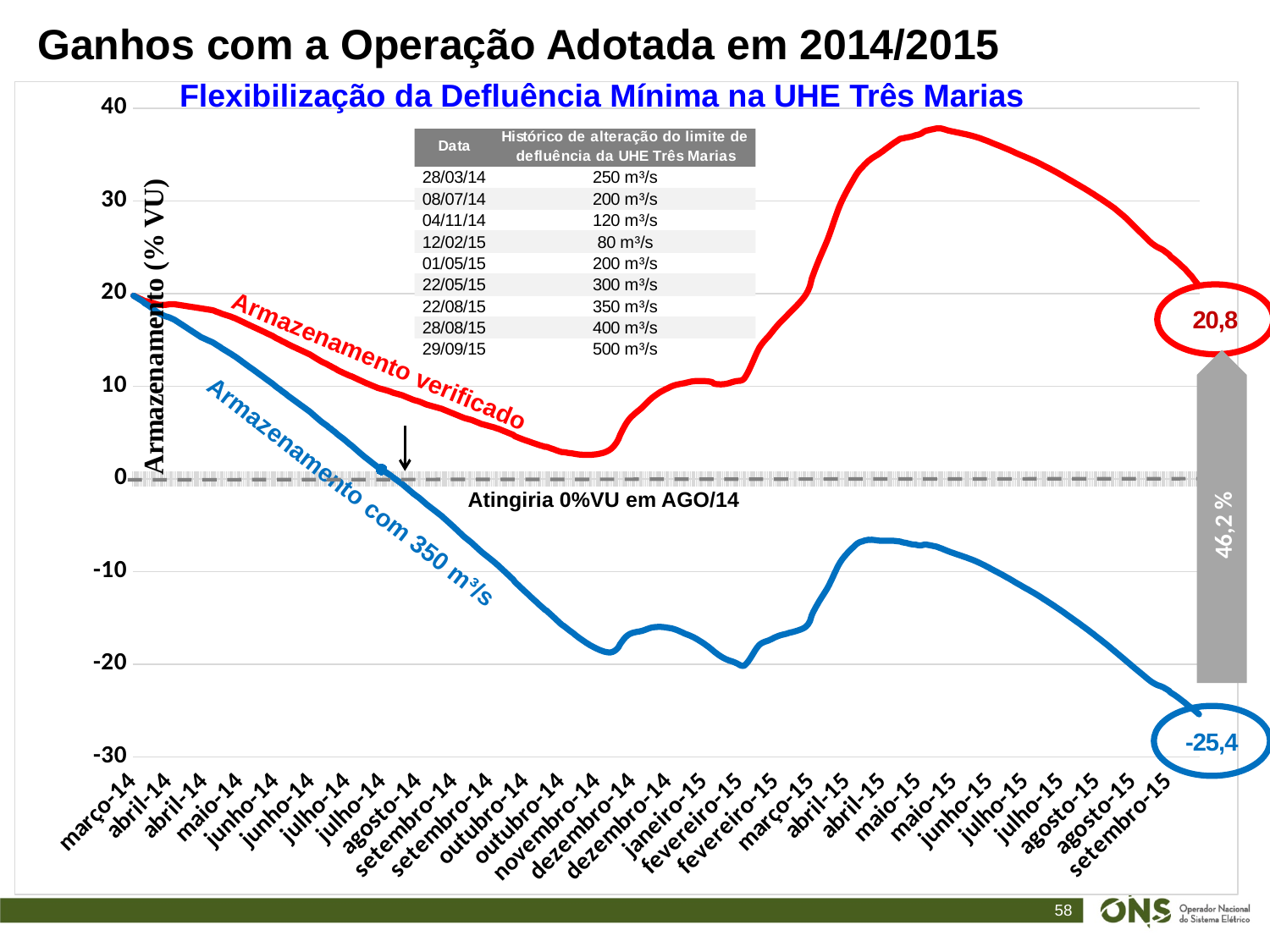
What is the final value of the 'Armazenamento verificado' series at setembro-15? 20,8 How many data series are plotted on the chart? 2 Is the peak value of the 'Armazenamento verificado' series around maio-15 greater or less than 30? greater At setembro-15, which series has the higher value: 'Armazenamento verificado' or 'Armazenamento com 350 m³/s'? Armazenamento verificado What kind of chart is shown on the slide? line chart Does the 'Armazenamento com 350 m³/s' series rise or fall from março-14 to dezembro-14? fall Is the lowest value of the 'Armazenamento verificado' series, around dezembro-14, greater or less than 0? greater Does the 'Armazenamento verificado' series rise or fall from maio-15 to setembro-15? fall What is the title of the y axis of the chart? Armazenamento (% VU) What is the final value of the 'Armazenamento com 350 m³/s' series at setembro-15? -25,4 Is the value of the 'Armazenamento com 350 m³/s' series at fevereiro-15 greater or less than -10? less What is the difference between the two series' final values at setembro-15, as shown on the slide? 46,2 %